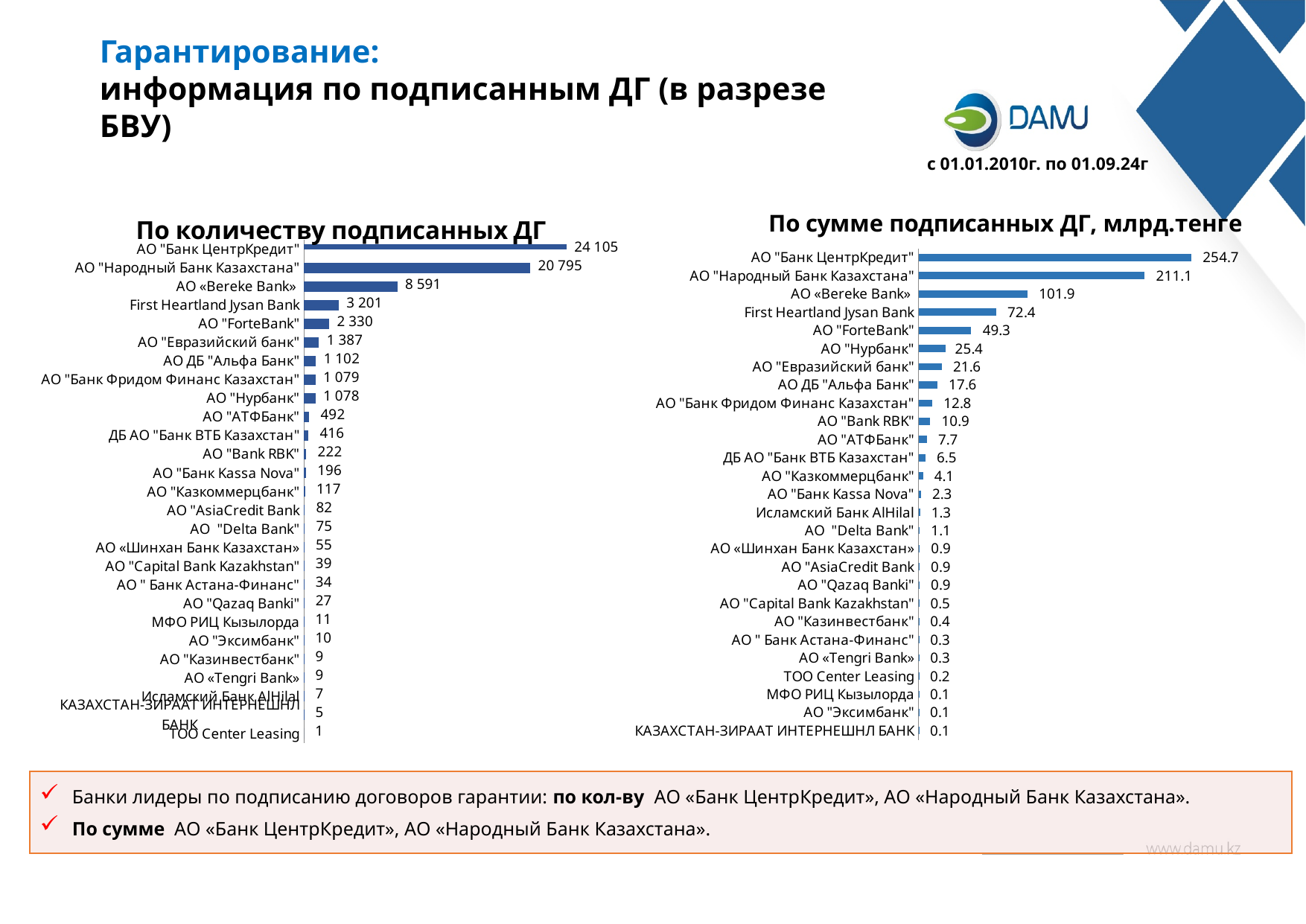
On the chart "По сумме подписанных ДГ, млрд.тенге", what is the value for АО «Bereke Bank»? 101.9 On the chart "По количеству подписанных ДГ", which is larger: АО "АТФБанк" or ДБ АО "Банк ВТБ Казахстан"? АО "АТФБанк" What type of chart is "По сумме подписанных ДГ, млрд.тенге"? Bar chart On the chart "По сумме подписанных ДГ, млрд.тенге", what is the difference between АО "Банк ЦентрКредит" and АО "Народный Банк Казахстана"? 43.6 On the chart "По количеству подписанных ДГ", which category has the lowest value? ТОО Center Leasing On the chart "По сумме подписанных ДГ, млрд.тенге", which is larger: АО "Евразийский банк" or АО ДБ "Альфа Банк"? АО "Евразийский банк" On the chart "По сумме подписанных ДГ, млрд.тенге", what is the value for АО "Нурбанк"? 25.4 What unit is stated in the title of the right-hand chart? млрд.тенге On the chart "По количеству подписанных ДГ", what is the value for АО "ForteBank"? 2 330 On the chart "По количеству подписанных ДГ", which bank has the highest value? АО "Банк ЦентрКредит" On the chart "По количеству подписанных ДГ", what is the difference between АО «Bereke Bank» and First Heartland Jysan Bank? 5 390 On the chart "По количеству подписанных ДГ", what is the value for АО "Народный Банк Казахстана"? 20 795